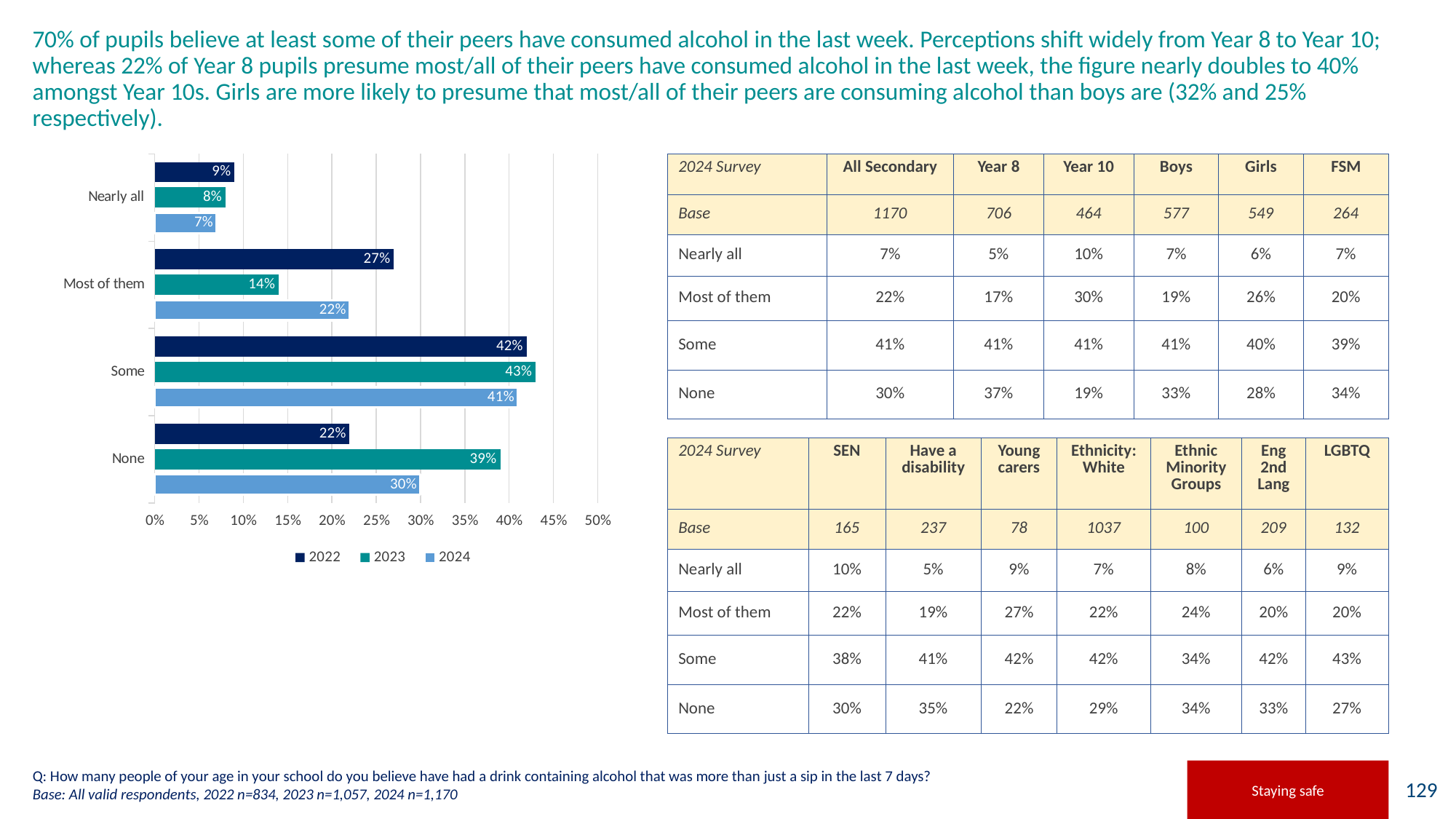
How many categories are shown on the chart? 4 Which category has the lowest 2023 value in the chart? Nearly all What is the 2022 value for 'Nearly all' in the chart? 9% What kind of chart is shown on the slide? bar chart Which series is shown in the darkest blue colour in the chart? 2022 What is the 2024 value for 'Most of them' in the chart? 22% Which is larger for 'None': the 2022 value or the 2024 value? 2024 What is the difference between the 2022 and 2023 values for 'Most of them'? 13% How many series does the chart legend list? 3 What is the 2023 value for 'None' in the chart? 39% Is the 2023 value for 'Some' greater or less than 40%? greater Which category has the highest 2024 value in the chart? Some